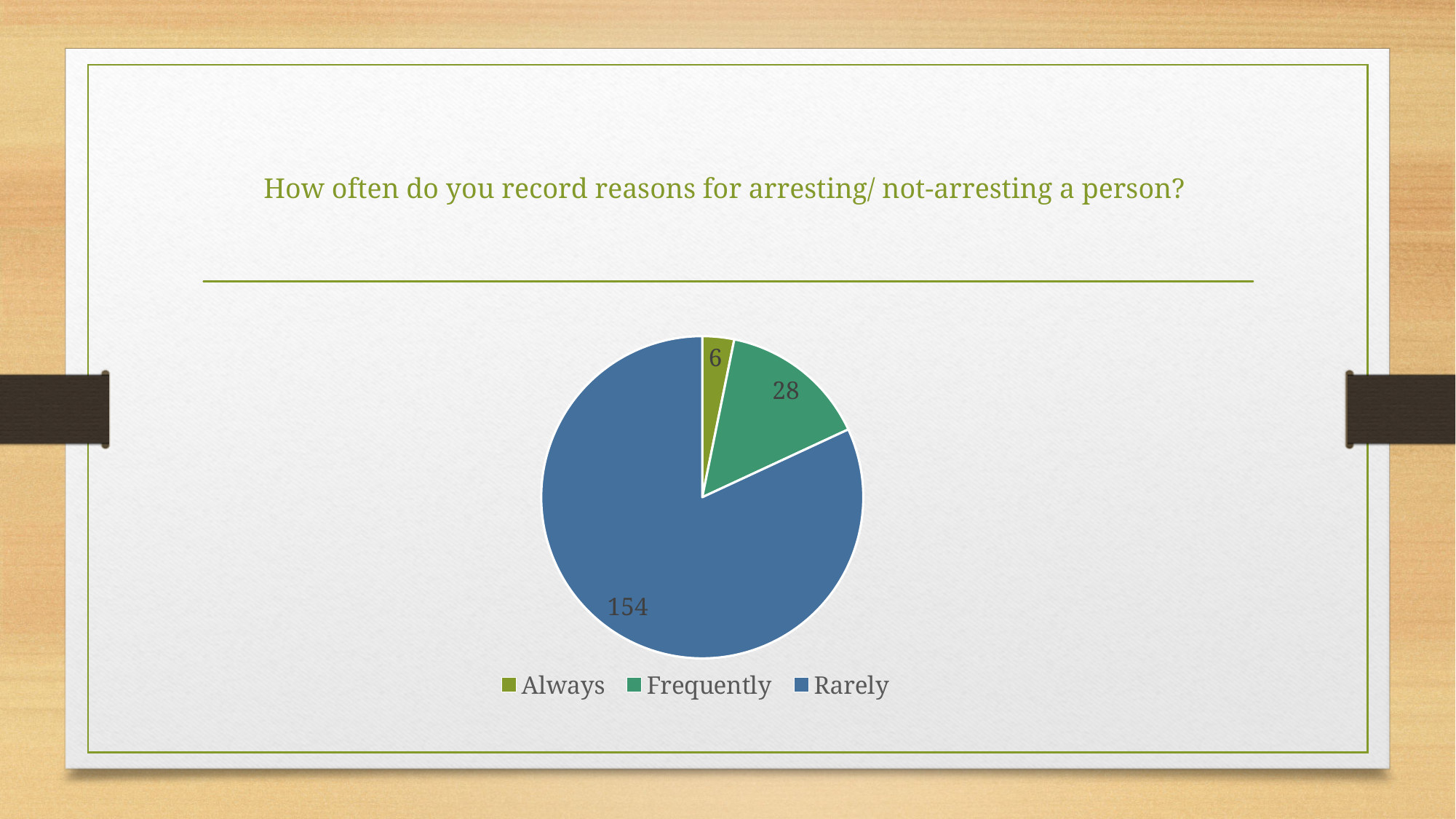
Which category has the smallest slice? Always What is the value for Rarely? 154 What is the difference between the values for Frequently and Always? 22 How many categories does the pie chart have? 3 Which category has the largest slice? Rarely What type of chart is shown on the slide? pie chart What is the value for Frequently? 28 What is the title of the chart? How often do you record reasons for arresting/ not-arresting a person? What is the total of all slices in the pie chart? 188 What is the value for Always? 6 Which is larger, the value for Frequently or the value for Always? Frequently What is the difference between the values for Rarely and Frequently? 126